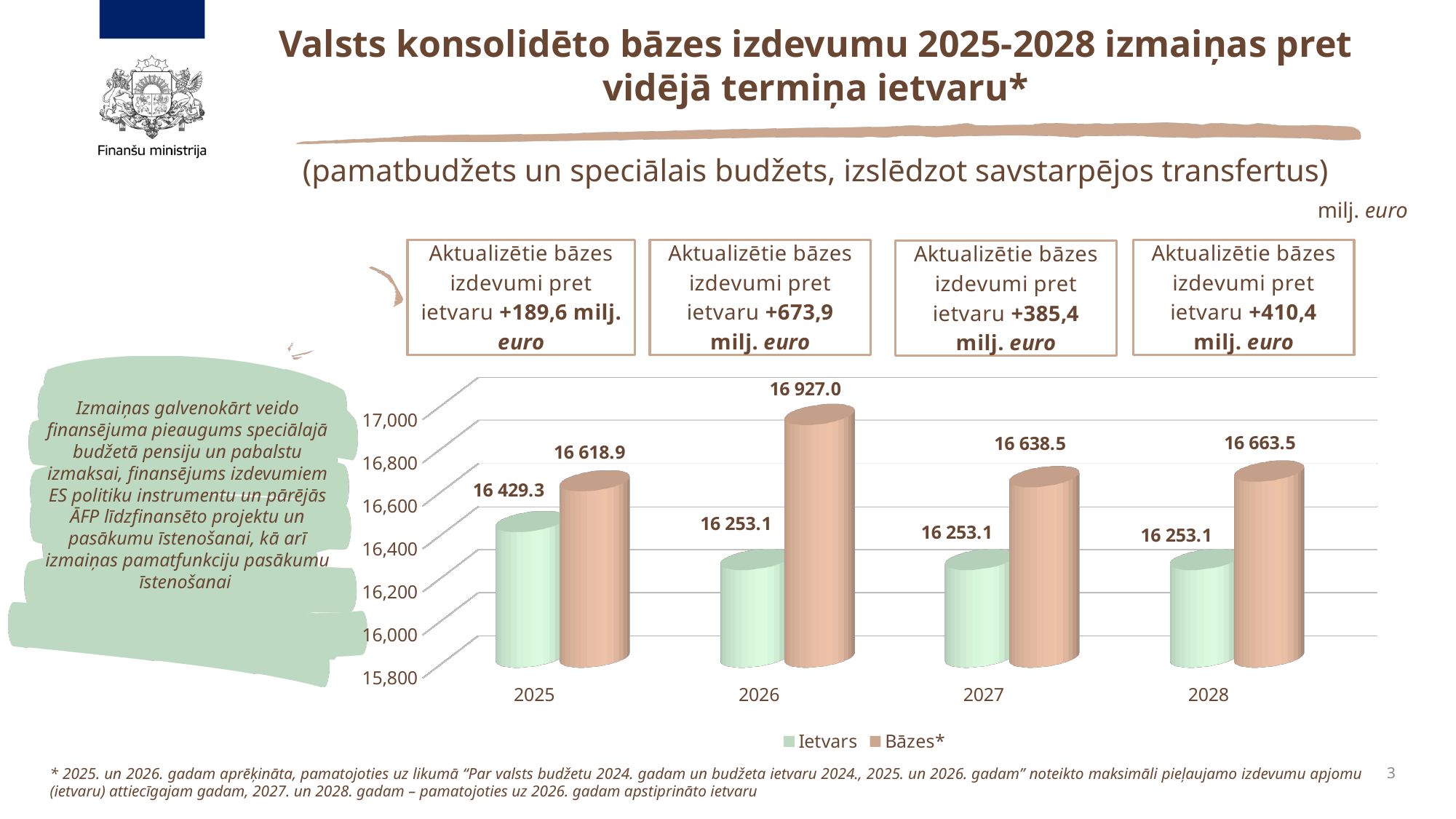
In which year is the Bāzes* value lowest? 2025 What is the value of Ietvars for 2025? 16 429.3 Which is larger in 2028, Ietvars or Bāzes*? Bāzes* How many years are shown on the x axis of the chart? 4 How many series does the chart legend list? 2 In which year is the Bāzes* value highest? 2026 What is the value of Bāzes* for 2028? 16 663.5 What is the difference between Bāzes* and Ietvars in 2025? 189.6 What kind of chart is shown on the slide? Bar chart What is the difference between Bāzes* and Ietvars in 2026? 673.9 What is the value of Bāzes* for 2026? 16 927.0 What is the value of Ietvars for 2027? 16 253.1